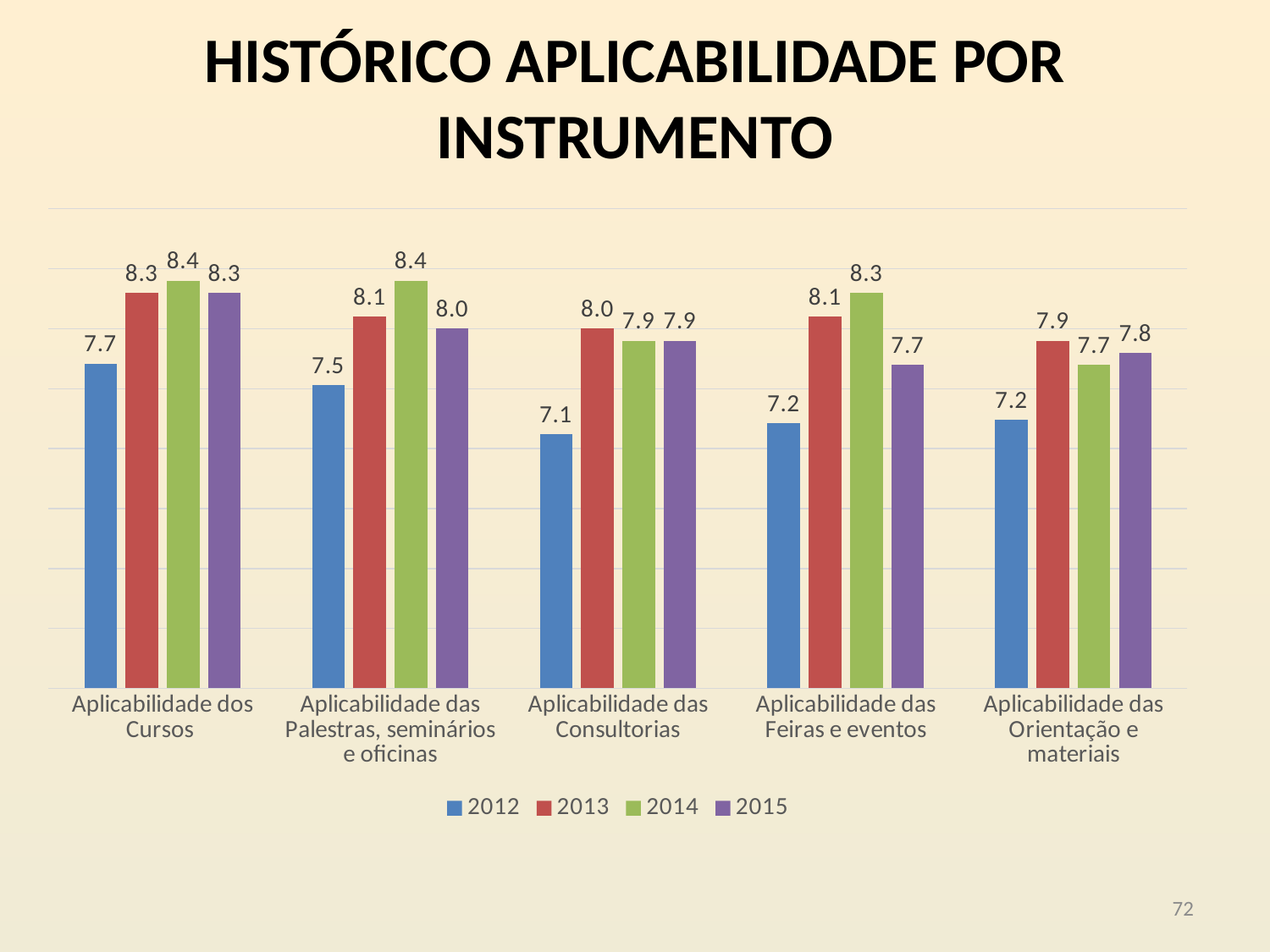
What is the 2015 value for Aplicabilidade das Orientação e materiais? 7.8 Which year has the lowest value for Aplicabilidade das Consultorias? 2012 How many series does the legend list? 4 How many categories are shown on the x axis? 5 What is the difference between the 2013 and 2012 values for Aplicabilidade das Feiras e eventos? 0.9 What is the title of the slide? HISTÓRICO APLICABILIDADE POR INSTRUMENTO What kind of chart is shown on the slide? Bar chart Which year has the highest value for Aplicabilidade das Feiras e eventos? 2014 Which colour represents the 2014 series in the legend? Green What is the 2012 value for Aplicabilidade dos Cursos? 7.7 Which is larger for Aplicabilidade das Palestras, seminários e oficinas: the 2013 value or the 2015 value? 2013 What is the 2014 value for Aplicabilidade das Palestras, seminários e oficinas? 8.4